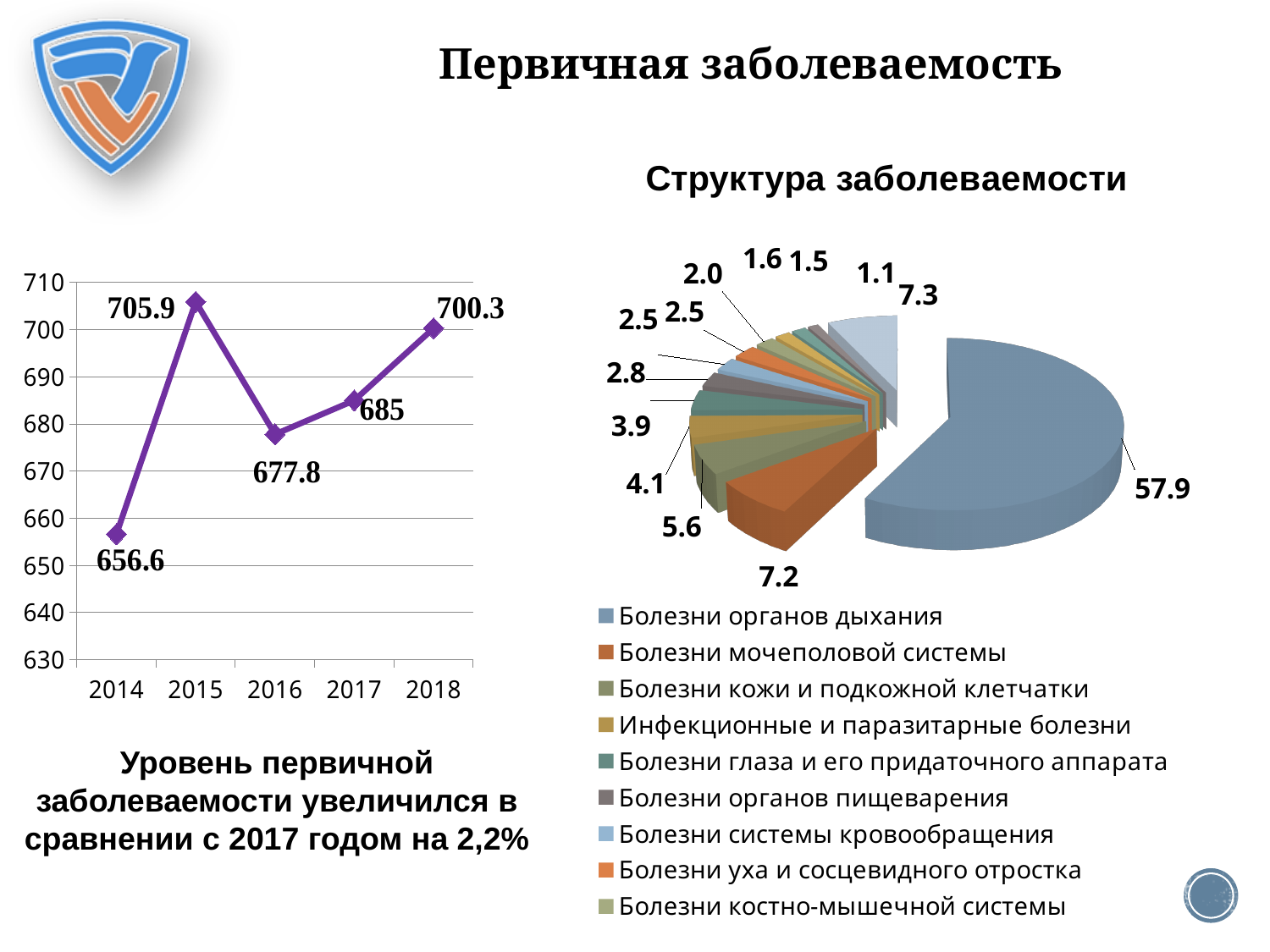
On the line chart on the left, which year has the lowest value? 2014 What kind of chart is the chart on the left of the slide? Line chart On the line chart on the left, which year has the highest value? 2015 On the line chart on the left, what is the value for 2015? 705.9 On the line chart on the left, what is the value for 2017? 685 On the line chart on the left, do the values rise or fall from 2016 to 2018? Rise On the line chart on the left, what is the value for 2014? 656.6 On the pie chart 'Структура заболеваемости', how many entries does the legend list? 9 On the line chart on the left, what is the difference between the values for 2018 and 2017? 15.3 On the line chart on the left, how many years are plotted? 5 On the line chart on the left, which year has the larger value, 2016 or 2017? 2017 On the pie chart 'Структура заболеваемости', what is the share of 'Болезни органов дыхания'? 57.9